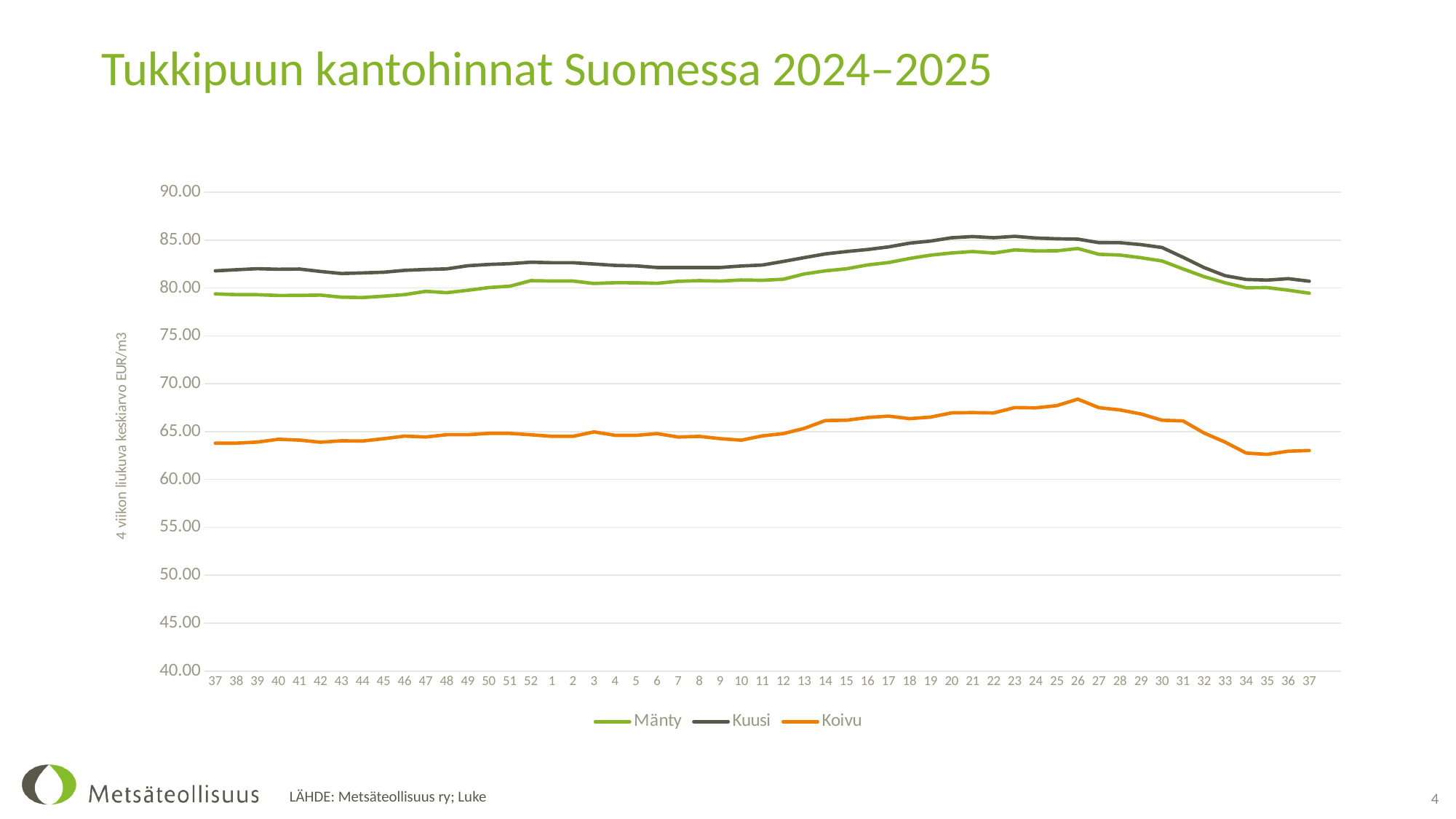
Which series has the lowest values across the whole period? Koivu Is the value for Kuusi at week 37 (the first point) greater or less than 80.00? greater What is the title of the chart? Tukkipuun kantohinnat Suomessa 2024–2025 Which series are listed in the legend? Mänty, Kuusi, Koivu How many series does the legend list? 3 Which series has the highest values across the whole period? Kuusi Is the value for Mänty at week 44 greater or less than 80.00? less Does the Koivu line rise or fall between week 26 and week 34? fall What kind of chart is shown on the slide? line chart Is the value for Koivu at week 34 greater or less than 65.00? less At week 20, which is larger, Kuusi or Koivu? Kuusi